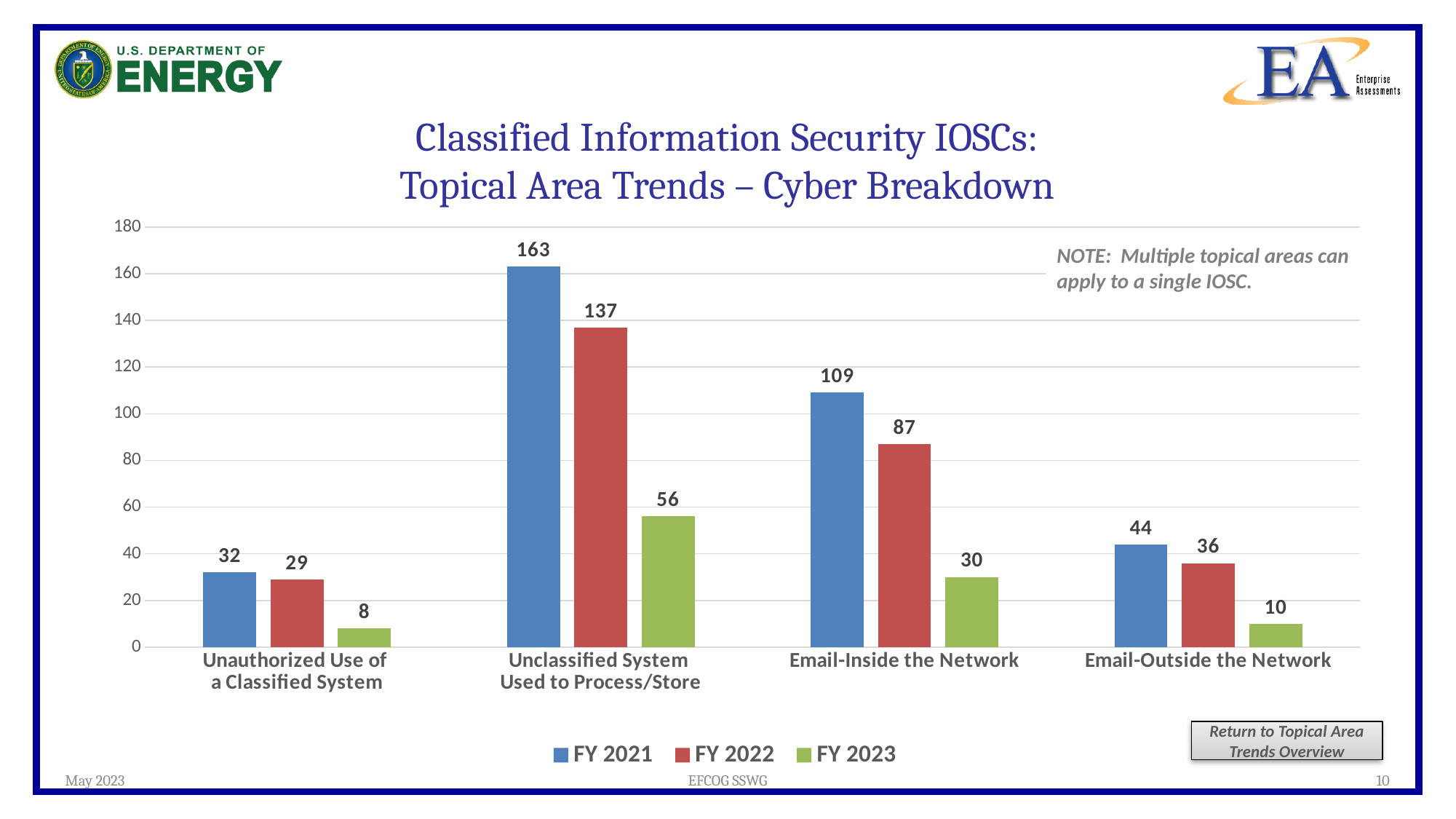
Which is larger: the FY 2021 value for Email-Outside the Network or the FY 2021 value for Unauthorized Use of a Classified System? Email-Outside the Network Which colour represents FY 2023 in the legend? Green What is the FY 2022 value for Email-Inside the Network? 87 How many categories are shown on the x axis? 4 How many series does the legend list? 3 What is the FY 2023 value for Unauthorized Use of a Classified System? 8 For Email-Inside the Network, do the values rise or fall from FY 2021 to FY 2023? Fall Which category has the highest FY 2021 value? Unclassified System Used to Process/Store What kind of chart is shown on the slide? Bar chart What is the difference between the FY 2021 and FY 2022 values for Unclassified System Used to Process/Store? 26 Which category has the lowest FY 2023 value? Unauthorized Use of a Classified System What is the FY 2021 value for Unclassified System Used to Process/Store? 163